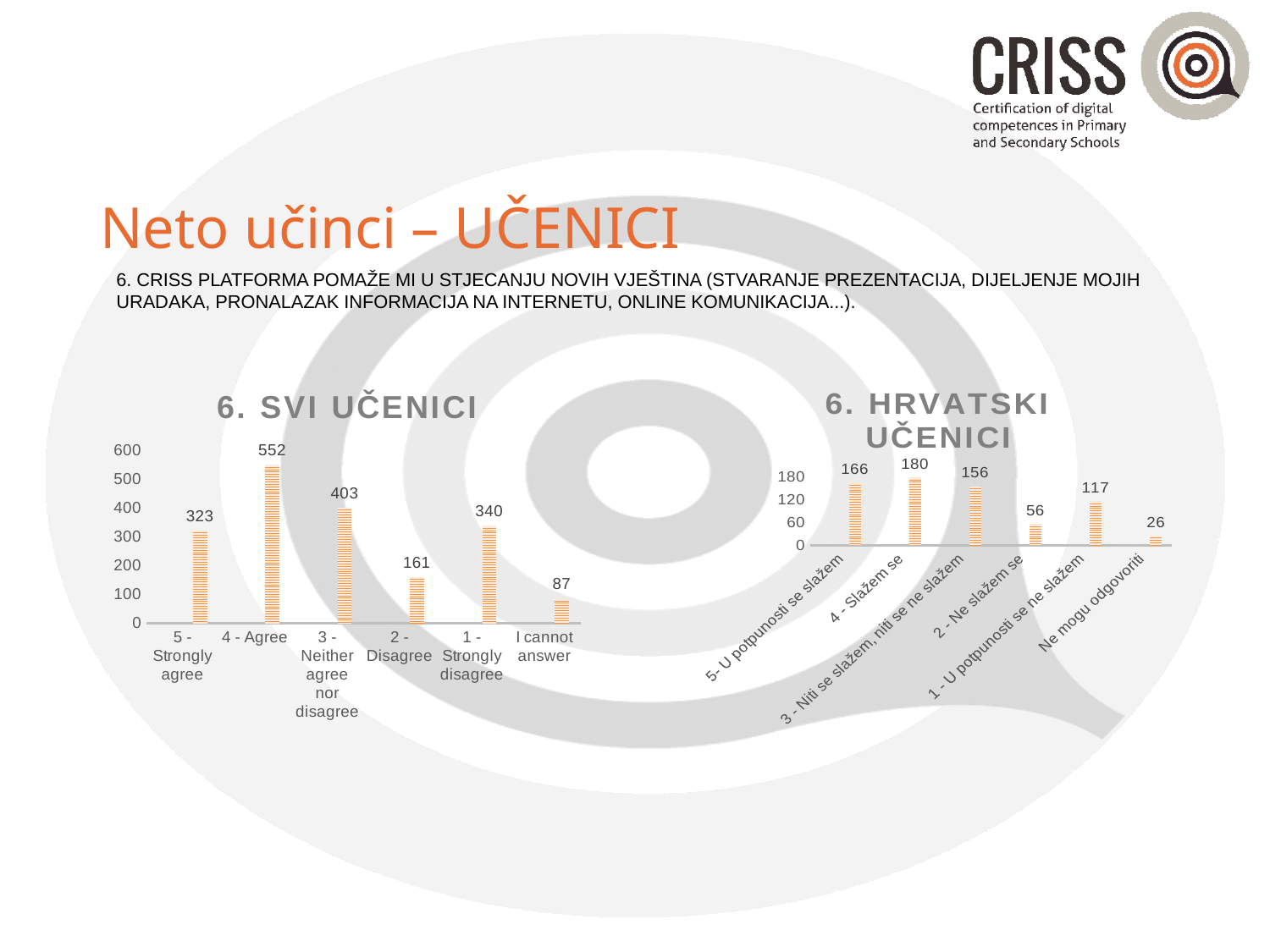
How many categories are shown in the "6. SVI UČENICI" chart? 6 In the "6. HRVATSKI UČENICI" chart, what is the value for "Ne mogu odgovoriti"? 26 In the "6. SVI UČENICI" chart, which category has the lowest value? I cannot answer In the "6. HRVATSKI UČENICI" chart, which category has the highest value? 4 - Slažem se In the "6. SVI UČENICI" chart, what is the difference between "4 - Agree" and "3 - Neither agree nor disagree"? 149 In the "6. SVI UČENICI" chart, what is the value for "4 - Agree"? 552 In the "6. HRVATSKI UČENICI" chart, is the value for "5 - U potpunosti se slažem" greater or less than 120? greater In the "6. HRVATSKI UČENICI" chart, what is the difference between "1 - U potpunosti se ne slažem" and "2 - Ne slažem se"? 61 What type of chart is "6. SVI UČENICI"? Bar chart In the "6. HRVATSKI UČENICI" chart, what is the value for "4 - Slažem se"? 180 How many categories are shown in the "6. HRVATSKI UČENICI" chart? 6 In the "6. SVI UČENICI" chart, which is larger: "5 - Strongly agree" or "1 - Strongly disagree"? 1 - Strongly disagree